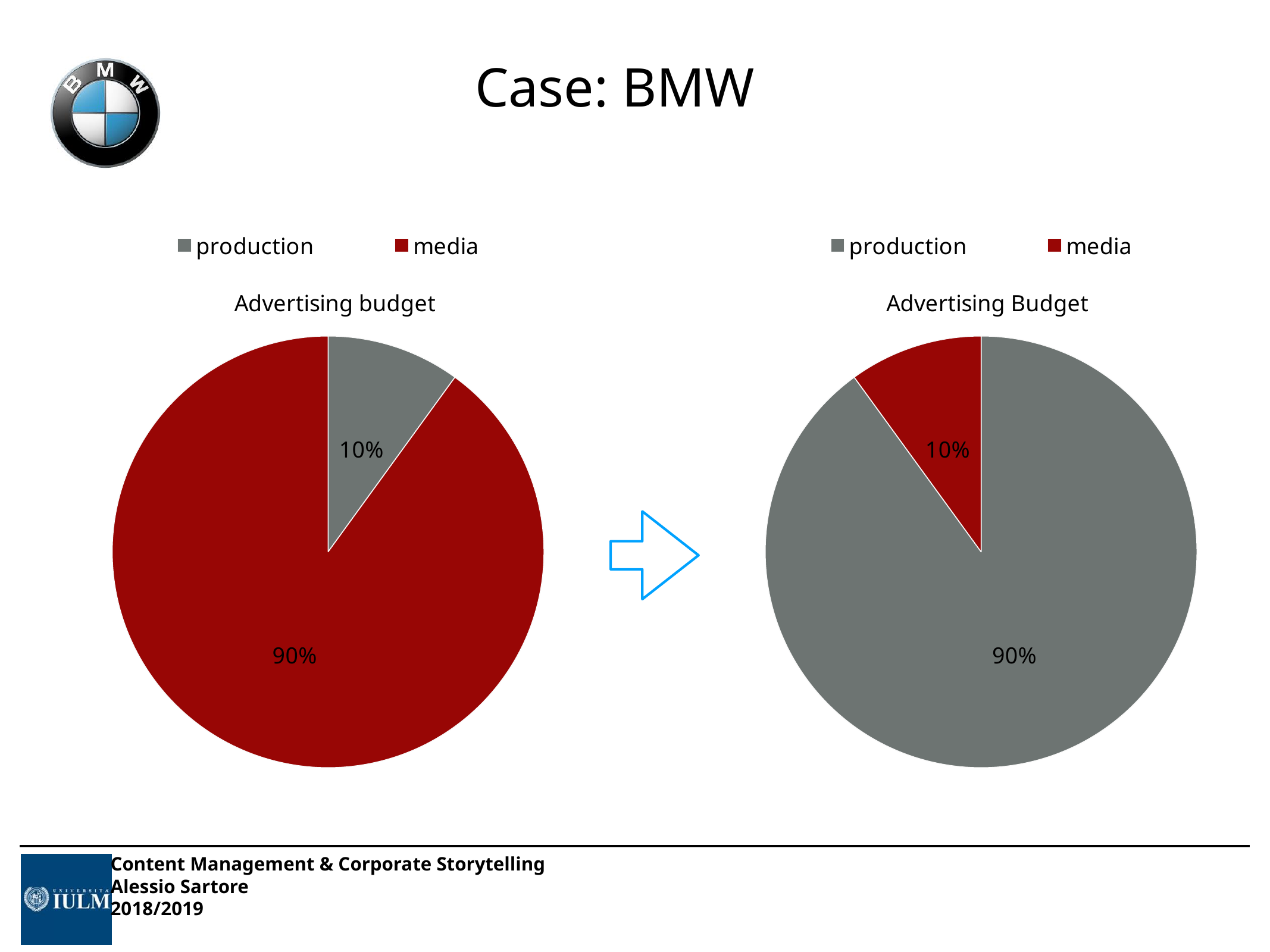
In the left pie chart, which category has the largest slice? media In the left pie chart, what share of the advertising budget goes to media? 90% In the right pie chart, what share of the advertising budget goes to production? 90% In the left pie chart, what share of the advertising budget goes to production? 10% How many entries does the legend of the right chart list? 2 What type of chart is shown on the right side of the slide? pie chart In the right pie chart, what share of the advertising budget goes to media? 10% In the right pie chart, which category has the smallest slice? media In the right pie chart, which is larger, production or media? production In the left pie chart, what is the difference between the media share and the production share? 80% How many slices does the left pie chart have? 2 In the left pie chart, what colour is the media slice? red